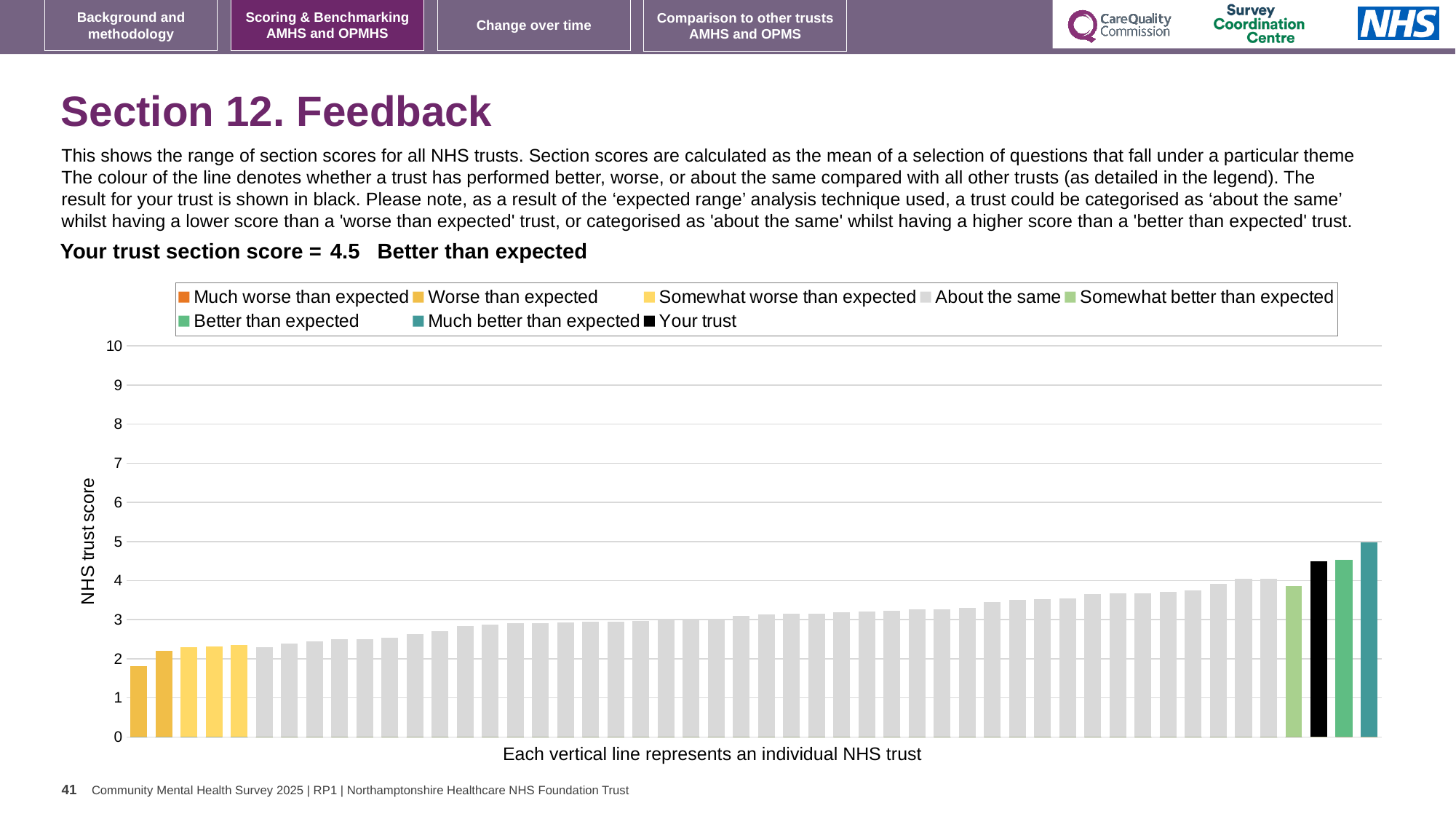
What is the section score for your trust shown on the slide? 4.5 Which performance category is your trust placed in for Section 12. Feedback? Better than expected What colour is used for the bar representing your trust? black Which is larger, the bar for your trust or the rightmost bar? the rightmost bar What is the label on the vertical axis of the chart? NHS trust score Do the bar values rise or fall from left to right along the x axis? rise How many entries does the chart legend list? 8 Is the value of the leftmost bar greater or less than 2? less Is the value of the rightmost bar greater or less than 4? greater What kind of chart is shown on the slide? bar chart Is the value for your trust greater or less than 4? greater Which legend category does the tallest bar belong to? Much better than expected